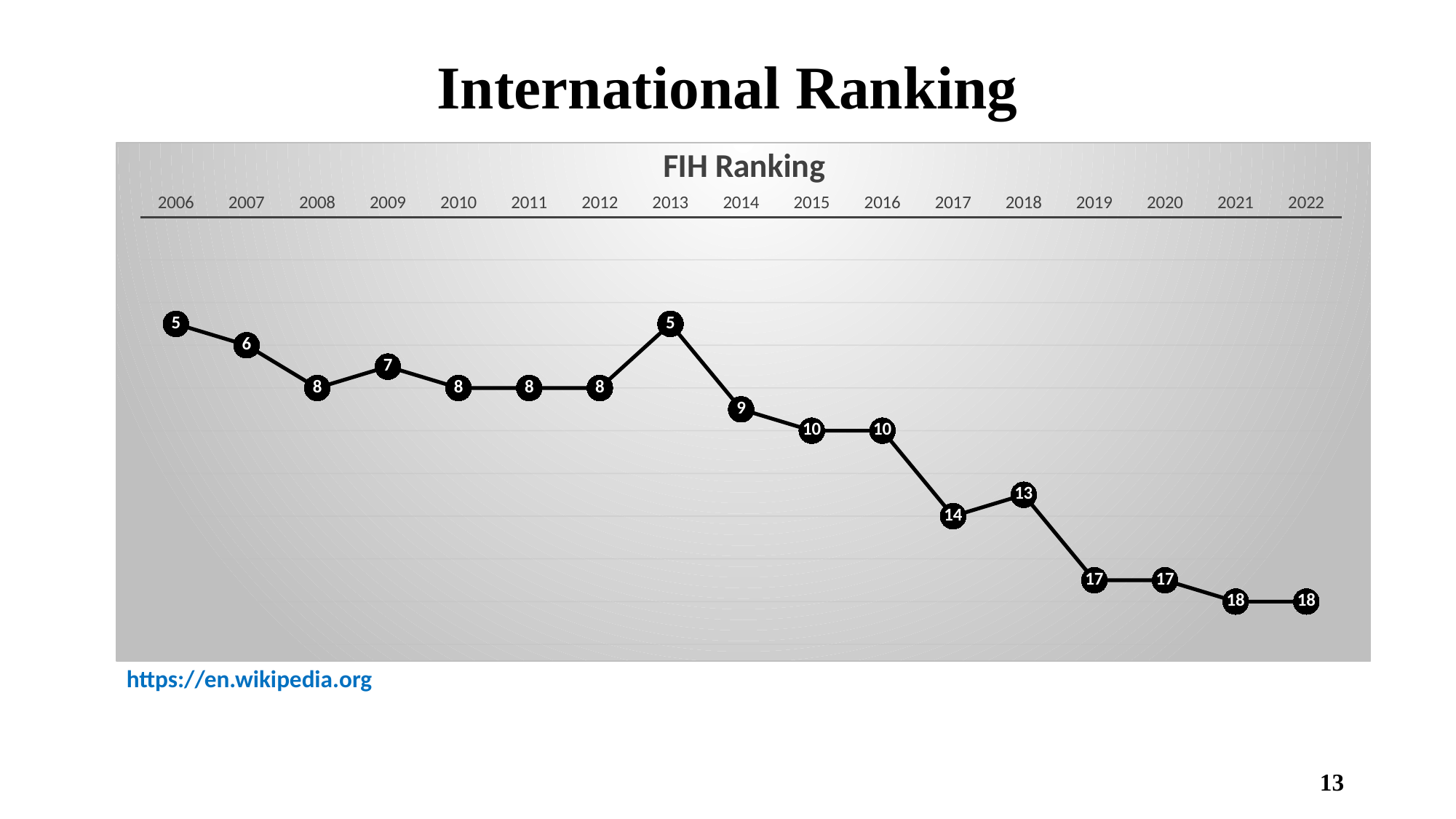
What is the FIH Ranking value for 2009? 7 What is the FIH Ranking value for 2013? 5 What is the FIH Ranking value for 2022? 18 What kind of chart is shown on the slide? Line chart What is the difference between the FIH Ranking values for 2018 and 2017? 1 How many years are plotted on the FIH Ranking chart? 17 Which year has the larger FIH Ranking value, 2014 or 2019? 2019 What is the FIH Ranking value for 2017? 14 What is the title of the chart on the slide? FIH Ranking What is the difference between the FIH Ranking values for 2022 and 2006? 13 What is the FIH Ranking value for 2006? 5 Do the FIH Ranking values generally rise or fall from 2006 to 2022? Rise